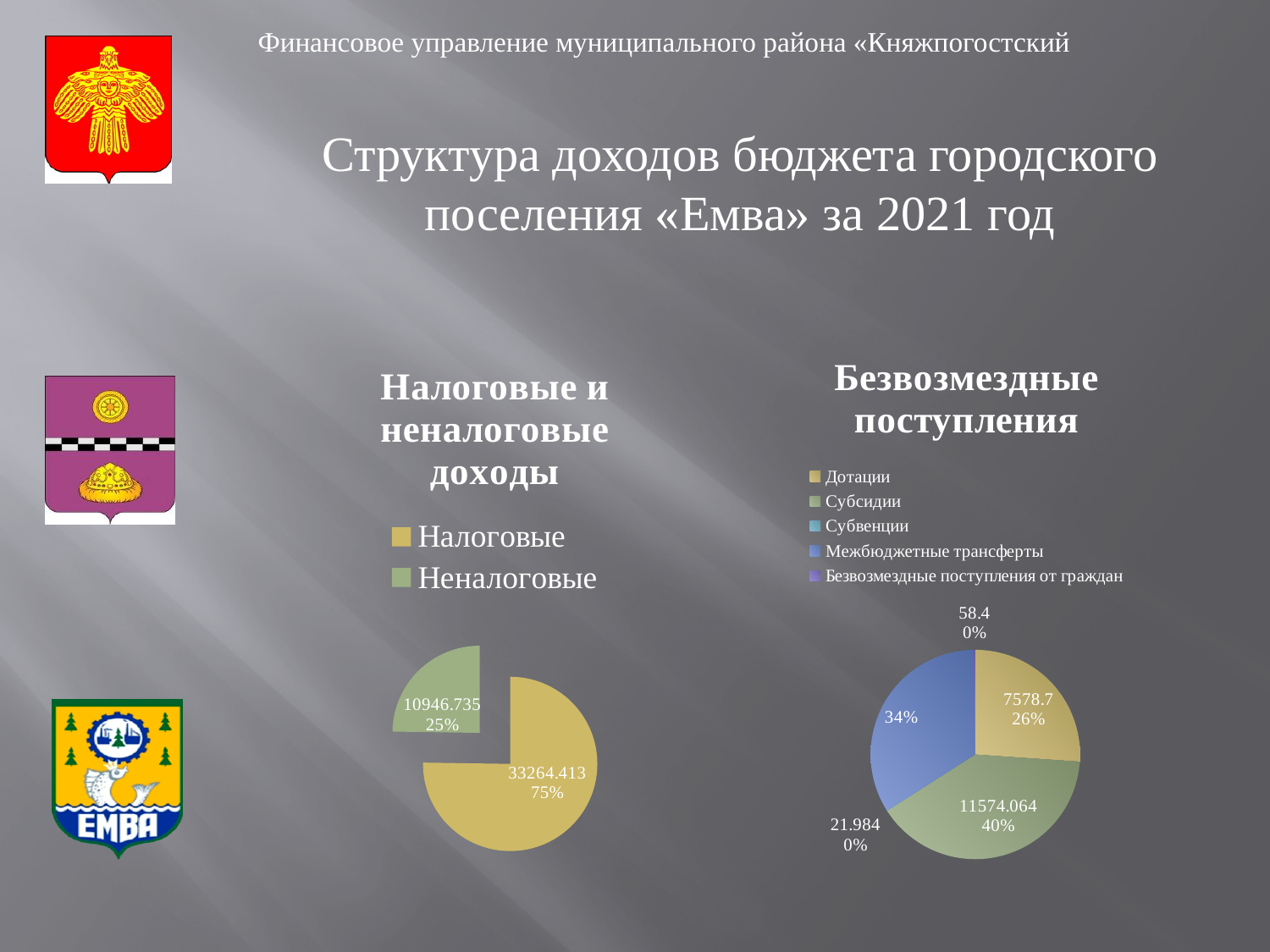
In the "Безвозмездные поступления" chart, what is the difference between the values for Субсидии and Дотации? 3995.364 In the "Налоговые и неналоговые доходы" chart, what share of the pie is Неналоговые? 25% How many categories does the legend of the "Налоговые и неналоговые доходы" chart list? 2 In the "Безвозмездные поступления" chart, what is the value for Субсидии? 11574.064 In the "Безвозмездные поступления" chart, what share of the pie is Межбюджетные трансферты? 34% How many categories does the legend of the "Безвозмездные поступления" chart list? 5 In the "Налоговые и неналоговые доходы" chart, what is the value for Неналоговые? 10946.735 In the "Безвозмездные поступления" chart, what is the value for Дотации? 7578.7 In the "Налоговые и неналоговые доходы" chart, which category is larger, Налоговые or Неналоговые? Налоговые In the "Безвозмездные поступления" chart, which category has the largest share? Субсидии In the "Налоговые и неналоговые доходы" chart, what is the value for Налоговые? 33264.413 What type of chart is used for "Налоговые и неналоговые доходы"? pie chart